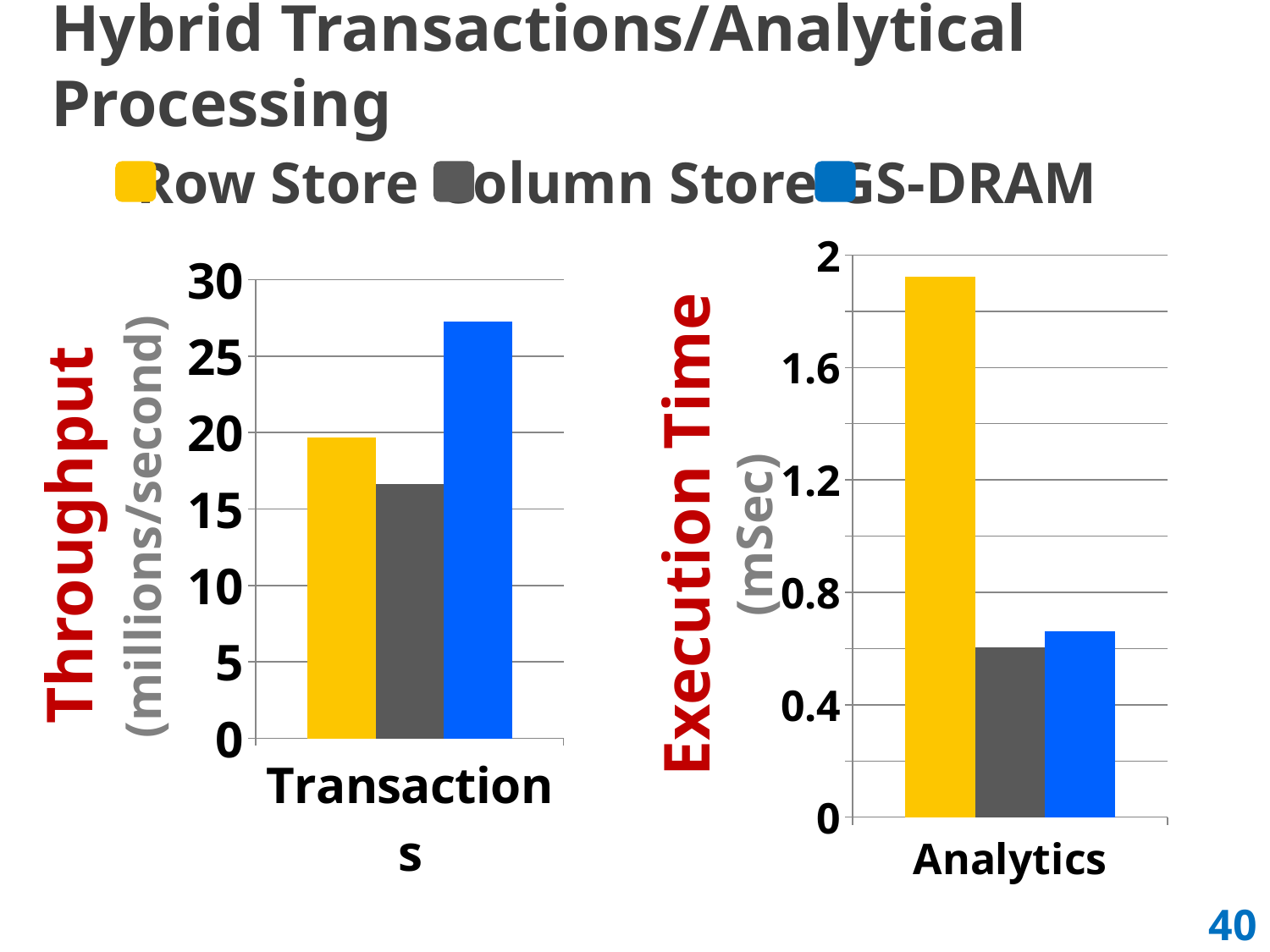
What kind of chart is the Execution Time chart? bar chart In the Throughput chart, which series has the highest value for Transactions? GS-DRAM In the Execution Time chart, is the value for Column Store greater or less than 0.8? less In the Execution Time chart, which is larger, the value for Row Store or the value for GS-DRAM? Row Store In the Throughput chart, is the value for Row Store greater or less than 15? greater In the Execution Time chart, is the value for Row Store greater or less than 1.6? greater In the Throughput chart, which series has the lowest value for Transactions? Column Store In the Throughput chart, which is larger, the value for Row Store or the value for Column Store? Row Store In the Execution Time chart, which series has the highest value for Analytics? Row Store How many series does the legend list? 3